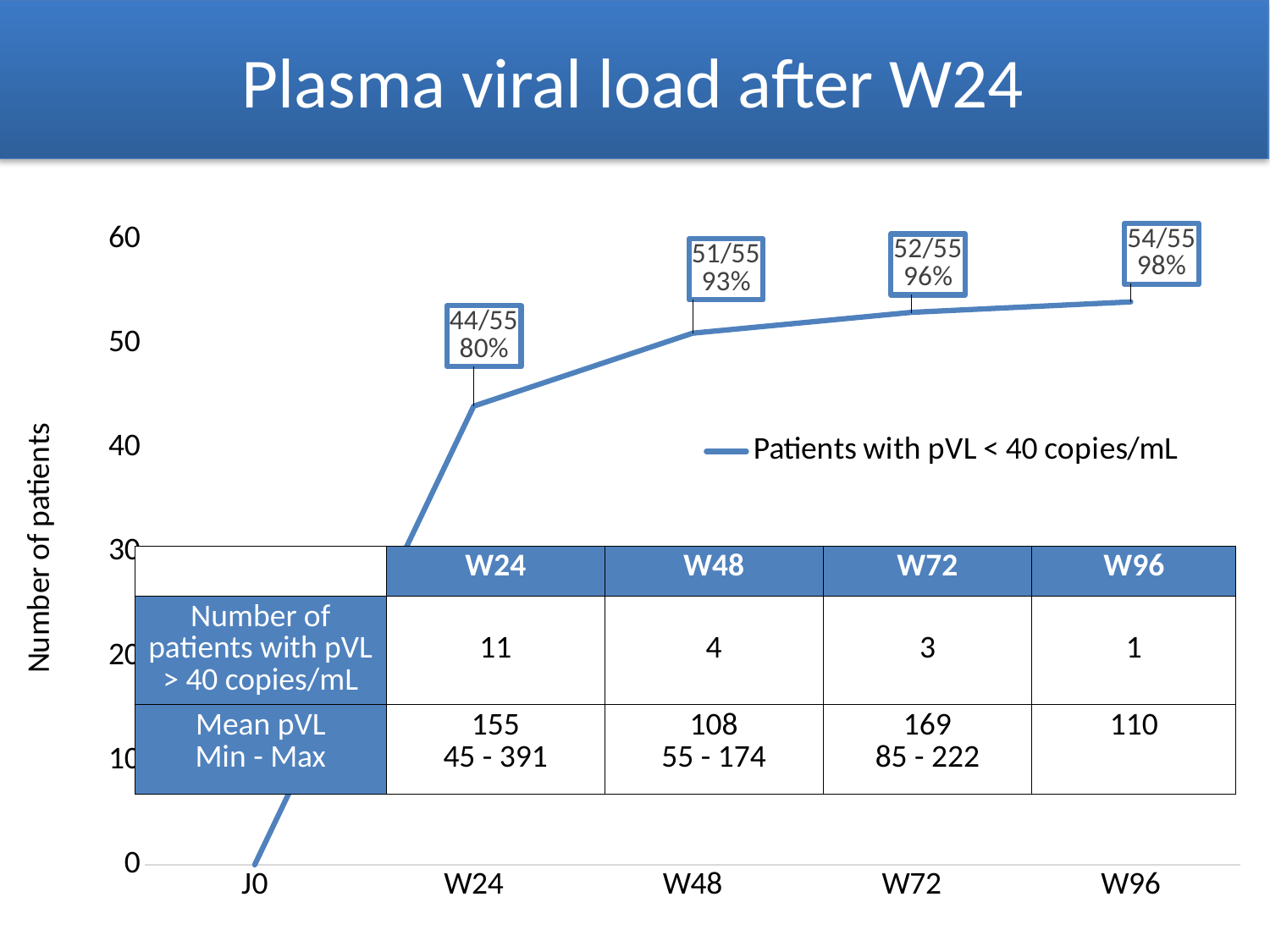
How many time points are plotted on the x axis? 5 What percentage of patients had pVL < 40 copies/mL at W48? 93% What is the name of the series shown in the legend? Patients with pVL < 40 copies/mL How many more patients had pVL < 40 copies/mL at W96 than at W24? 10 What percentage of patients had pVL < 40 copies/mL at W96? 98% Does the number of patients with pVL < 40 copies/mL rise or fall from J0 to W96? rise How many series does the legend list? 1 At which time point is the number of patients with pVL < 40 copies/mL highest? W96 How many patients had pVL < 40 copies/mL at W24 according to the data label? 44/55 What is the data label shown at W72? 52/55 96% What type of chart is shown on the slide? line chart What is the title of the slide chart? Plasma viral load after W24